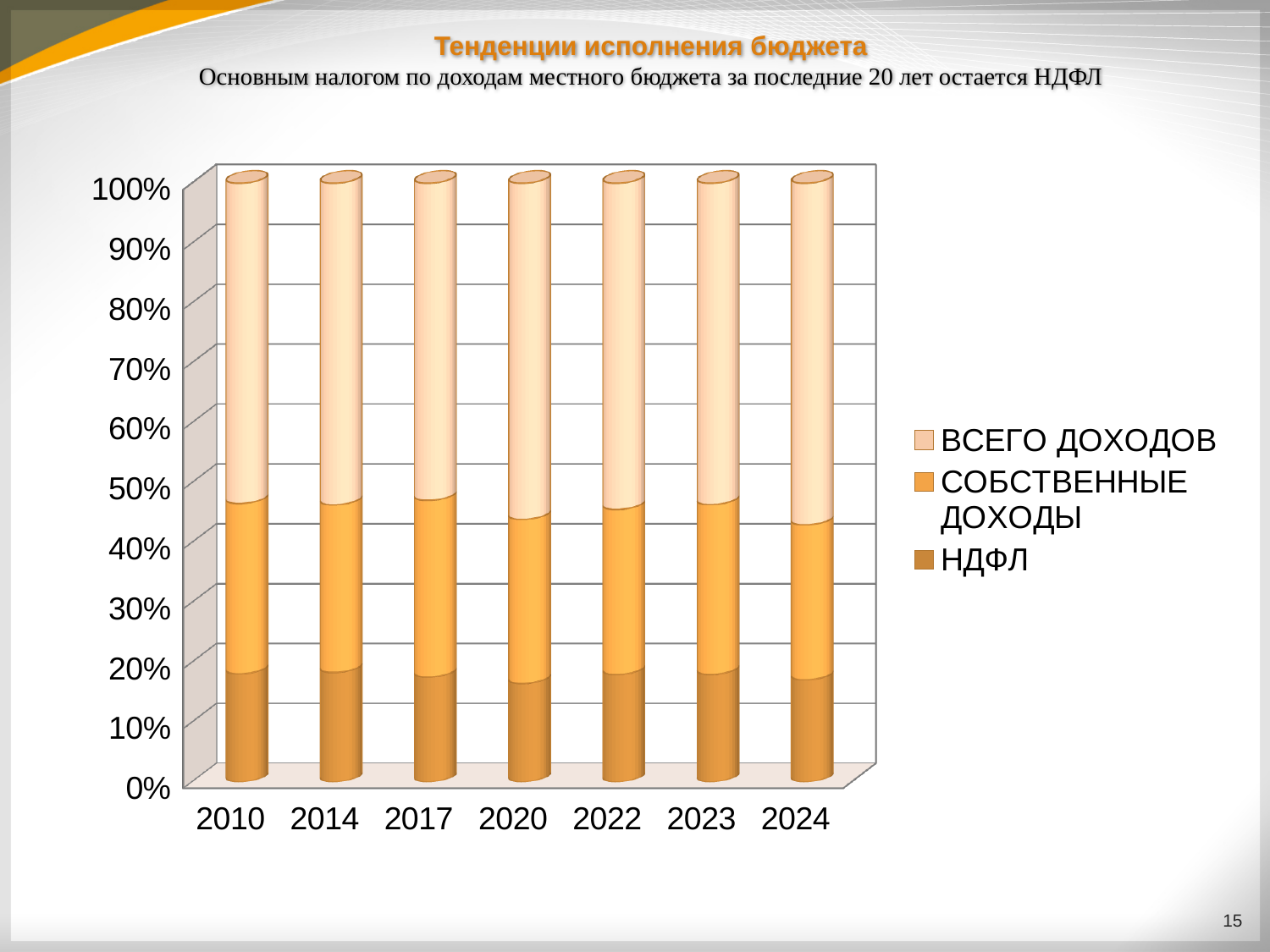
Which year is the first category on the x axis? 2010 How many series does the chart legend list? 3 Is the top of the НДФЛ segment in 2010 greater or less than 30%? less What is the maximum value shown on the y axis of the chart? 100% What kind of chart is shown on the slide? Stacked bar chart How many years are shown on the x axis of the chart? 7 Is the top of the СОБСТВЕННЫЕ ДОХОДЫ segment in 2010 greater or less than 40%? greater Is the top of the НДФЛ segment in 2020 greater or less than 30%? less Which series is shown at the bottom of each stacked bar? НДФЛ